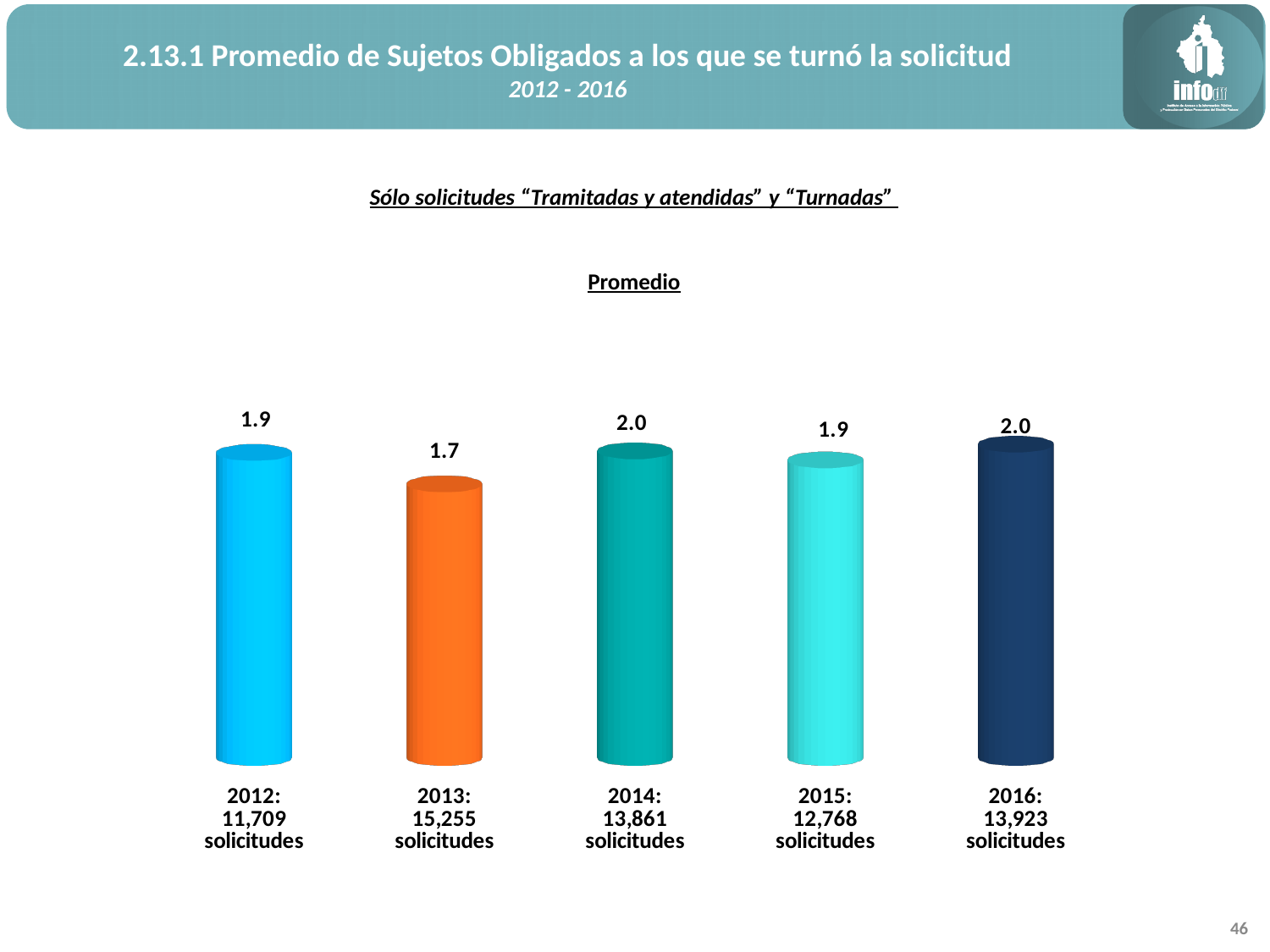
How many solicitudes are listed in the category label for 2015? 12,768 What is the value shown for 2013? 1.7 Does the value rise or fall from 2012 to 2013? Fall What is the heading shown directly above the chart? Promedio What is the average (promedio) value shown for 2012? 1.9 What is the value shown for 2016? 2.0 What is the difference between the values for 2014 and 2013? 0.3 How many years (bars) are shown in the chart? 5 Which is larger, the value for 2012 or the value for 2013? 2012 What is the value shown for 2014? 2.0 Which year has the lowest average value? 2013 What kind of chart is shown on the slide? Bar chart